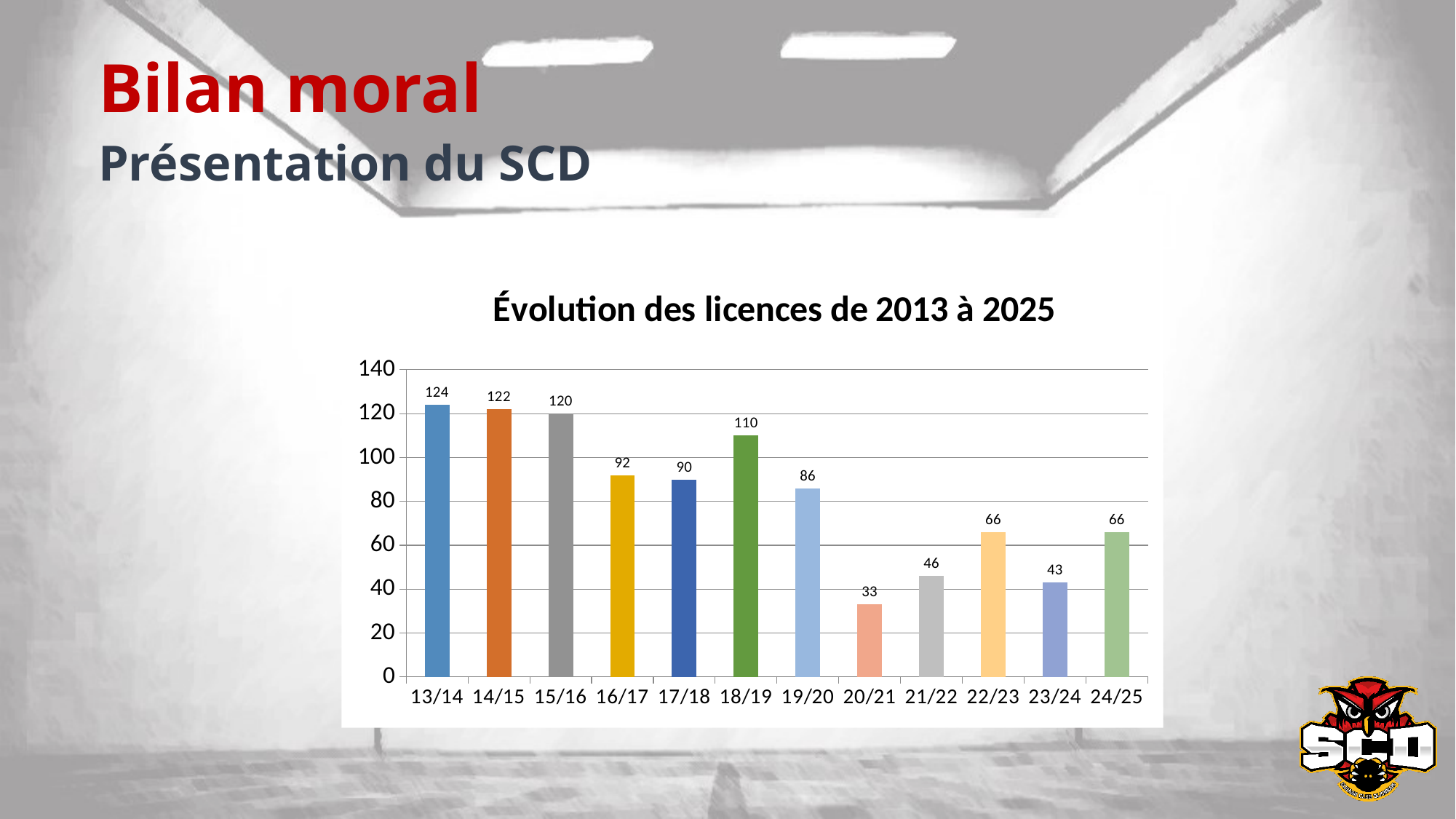
What is the title of the chart? Évolution des licences de 2013 à 2025 What is the value for 20/21? 33 Which is larger, the value for 21/22 or the value for 23/24? 21/22 Is the value for 19/20 greater or less than 100? less What is the value for 18/19? 110 How many seasons are shown on the x axis? 12 Which season has the lowest value? 20/21 What is the difference between the values for 13/14 and 24/25? 58 Do the values generally rise or fall from 13/14 to 20/21? fall Which season has the highest value? 13/14 What kind of chart is shown on the slide? bar chart What is the value for 13/14? 124